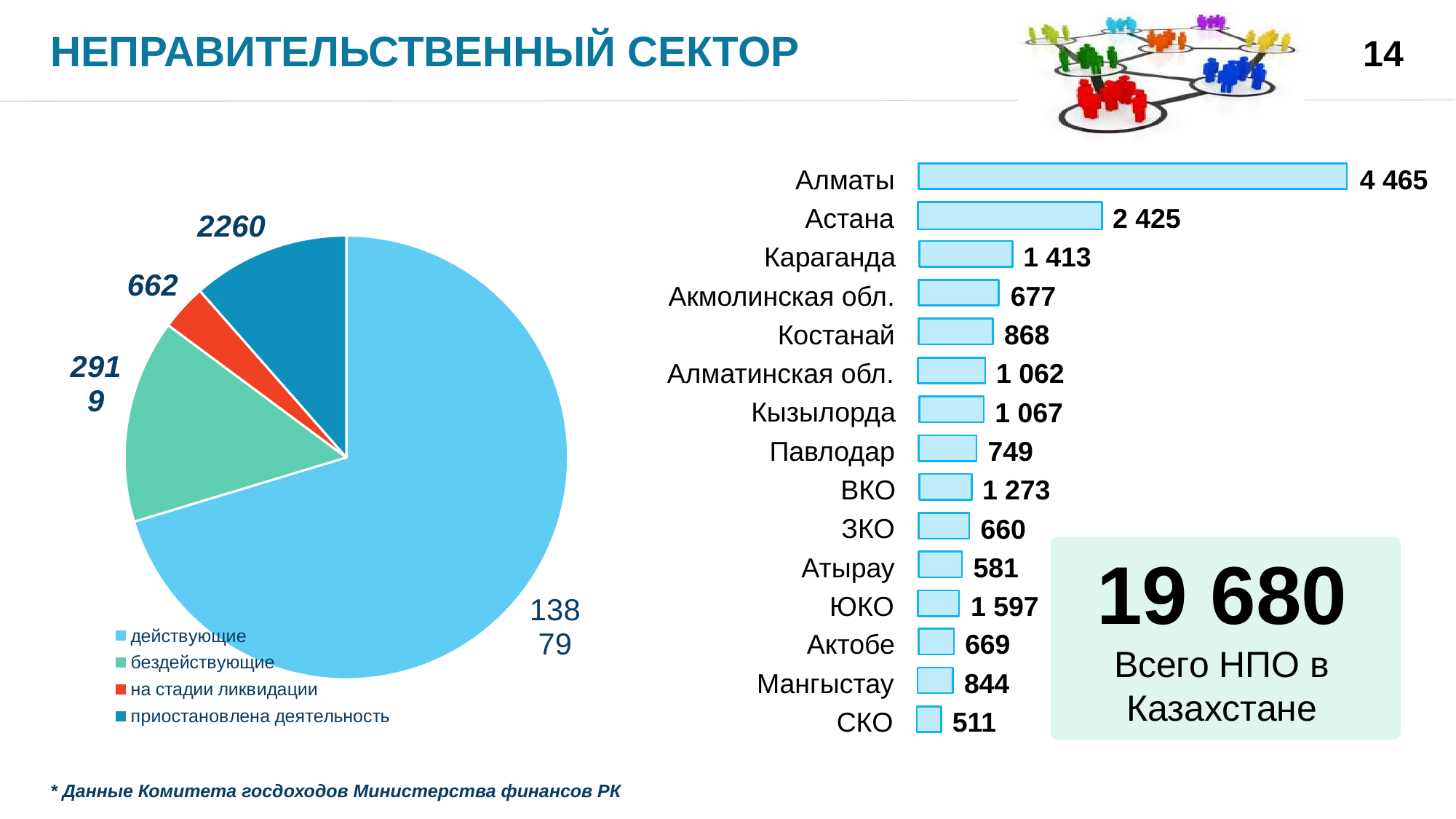
How many regions are listed in the bar chart on the right? 15 What kind of chart is shown on the right side of the slide? bar chart In the pie chart on the left, which category has the largest slice? действующие In the bar chart on the right, which region has the highest value? Алматы In the bar chart on the right, which region has the lowest value? СКО In the bar chart on the right, what is the value for Алматы? 4 465 In the bar chart on the right, what is the value for Караганда? 1 413 In the pie chart on the left, what is the value for 'на стадии ликвидации'? 662 What kind of chart is shown on the left side of the slide? pie chart In the pie chart on the left, what is the value for 'приостановлена деятельность'? 2260 In the bar chart on the right, which is larger, the value for Костанай or the value for Павлодар? Костанай In the bar chart on the right, what is the difference between the values for Алматы and Астана? 2 040